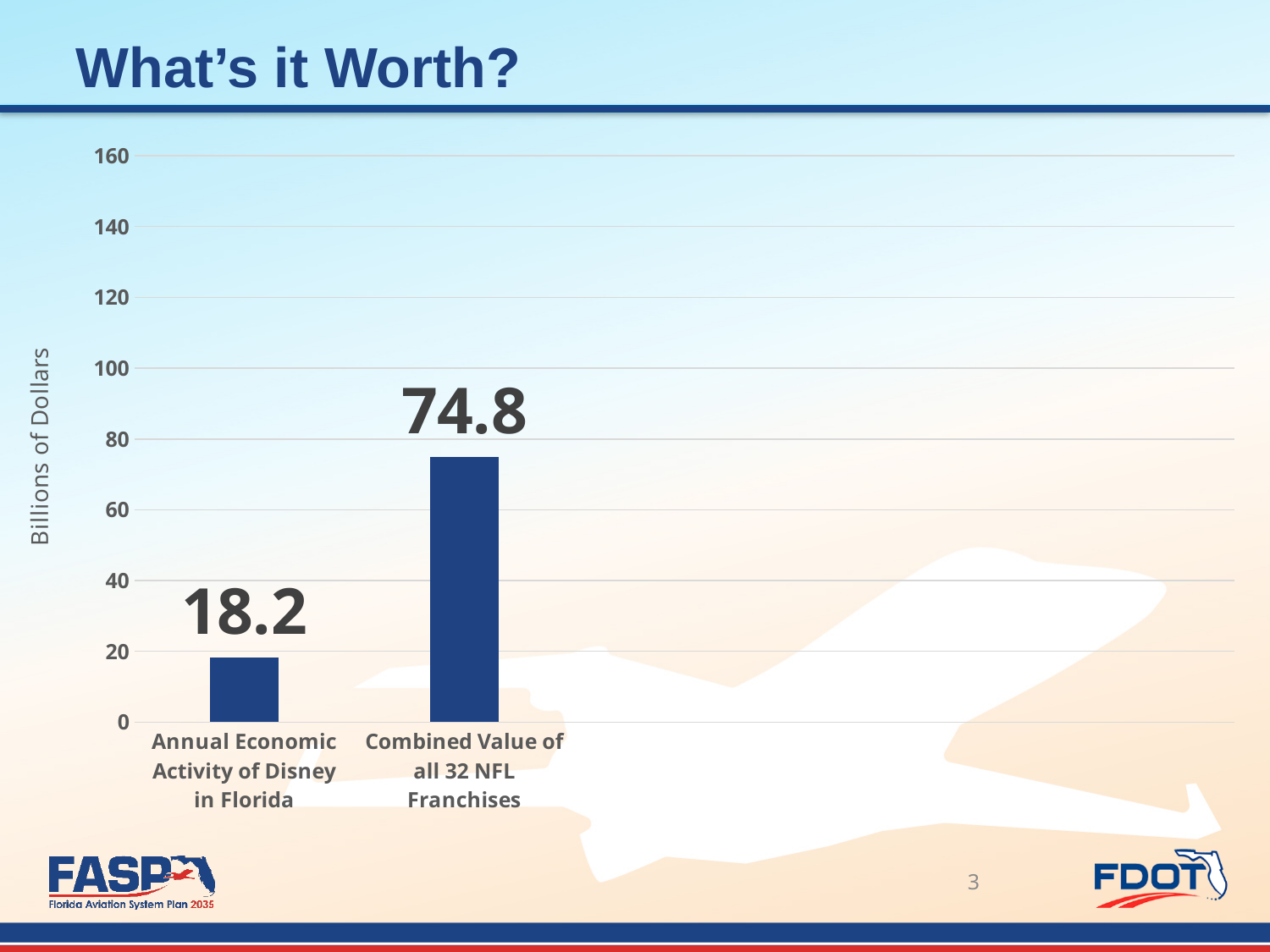
What is the maximum value shown on the vertical axis? 160 What is the label of the vertical axis? Billions of Dollars How many categories are shown in the chart? 2 What is the value for Combined Value of all 32 NFL Franchises? 74.8 Is the value for Combined Value of all 32 NFL Franchises greater or less than 80? less What is the value for Annual Economic Activity of Disney in Florida? 18.2 Which category has the lowest value? Annual Economic Activity of Disney in Florida Which category has the highest value? Combined Value of all 32 NFL Franchises Is the value for Annual Economic Activity of Disney in Florida greater or less than 20? less What kind of chart is shown on the slide? bar chart What is the difference between the Combined Value of all 32 NFL Franchises and the Annual Economic Activity of Disney in Florida? 56.6 Which is larger: the Annual Economic Activity of Disney in Florida or the Combined Value of all 32 NFL Franchises? Combined Value of all 32 NFL Franchises